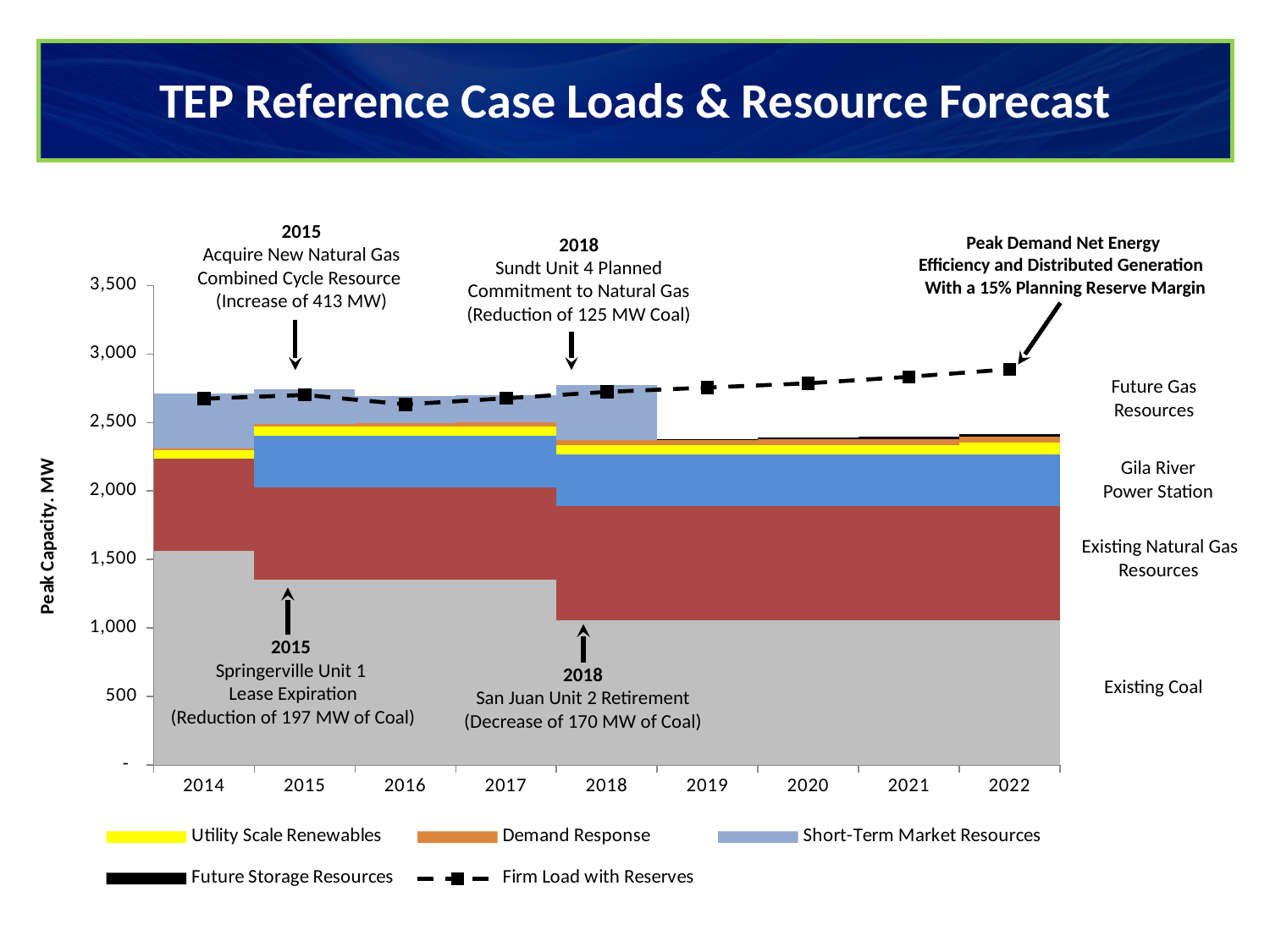
Is the Firm Load with Reserves value for 2014 greater or less than 2,500? greater Is the Existing Coal capacity in 2016 greater or less than 1,500? less According to the annotation, by how many MW does the new natural gas combined cycle resource acquired in 2015 increase capacity? 413 MW What is the title of the chart on the slide? TEP Reference Case Loads & Resource Forecast How many series does the chart's legend list? 5 Is the Firm Load with Reserves value for 2022 greater or less than 3,000? less What is the label on the vertical axis of the chart? Peak Capacity, MW What kind of chart is shown on the slide? Stacked bar chart with a line overlay How many years are shown along the x axis of the chart? 9 According to the annotation, how much coal capacity is reduced by the Springerville Unit 1 lease expiration in 2015? 197 MW Does the Firm Load with Reserves line rise or fall from 2018 to 2022? rise